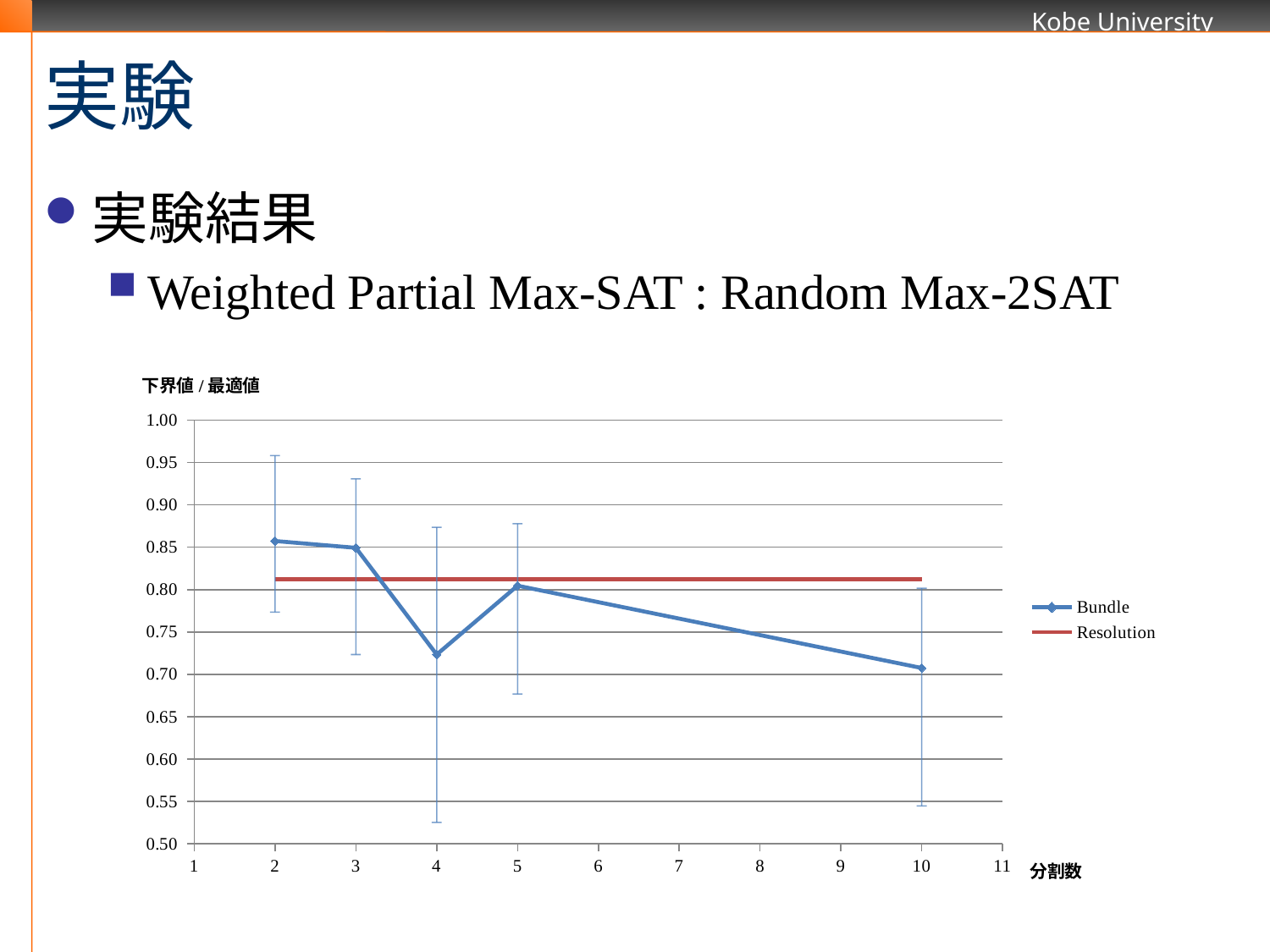
How many data points are plotted for the Bundle series? 5 Does the Bundle series overall rise or fall as 分割数 increases from 2 to 10? fall How many series does the legend list? 2 Is the Bundle value at 分割数 = 10 greater or less than 0.75? less At 分割数 = 10, which series has the larger value, Bundle or Resolution? Resolution What kind of chart is shown on the slide? line chart Is the Bundle value at 分割数 = 4 greater or less than 0.75? less What are the two series named in the legend? Bundle, Resolution Which is larger, the Bundle value at 分割数 = 2 or at 分割数 = 4? 分割数 = 2 What is the label on the horizontal axis of the chart? 分割数 Is the Resolution line greater or less than 0.80? greater